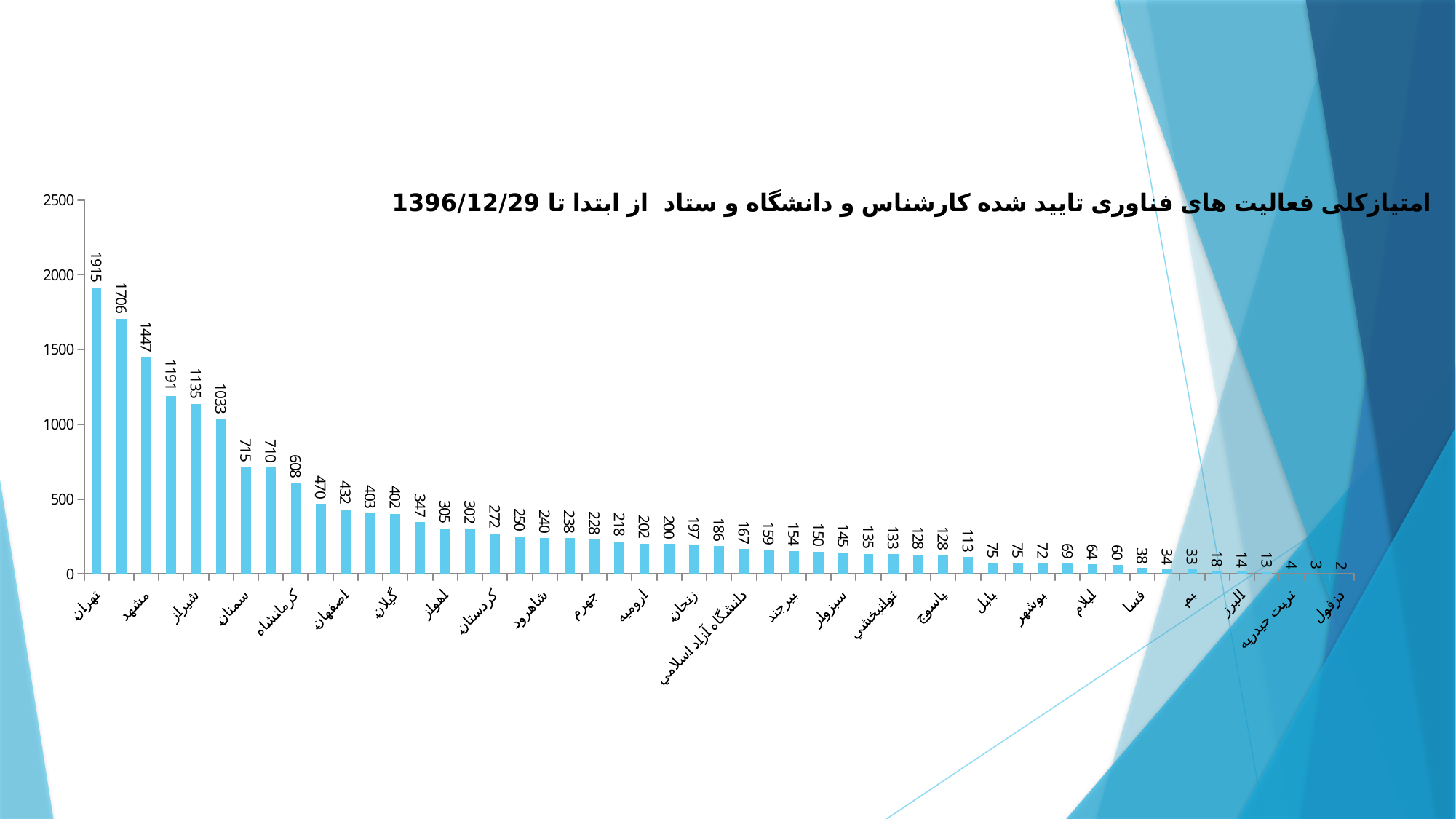
Do the bar values rise or fall from left to right along the x axis? fall Which has the larger value, تهران or دزفول? تهران What is the value of the tallest bar in the chart? 1915 Which category has the highest value in the chart? تهران Is the value for تهران greater or less than 1500? greater Which category has the lowest value in the chart? دزفول What date appears at the end of the chart title? 1396/12/29 What kind of chart is shown on the slide? bar chart What is the difference between the value for تهران and the value for دزفول? 1913 What is the highest tick value shown on the vertical axis? 2500 What is the value of the last bar (دزفول) in the chart? 2